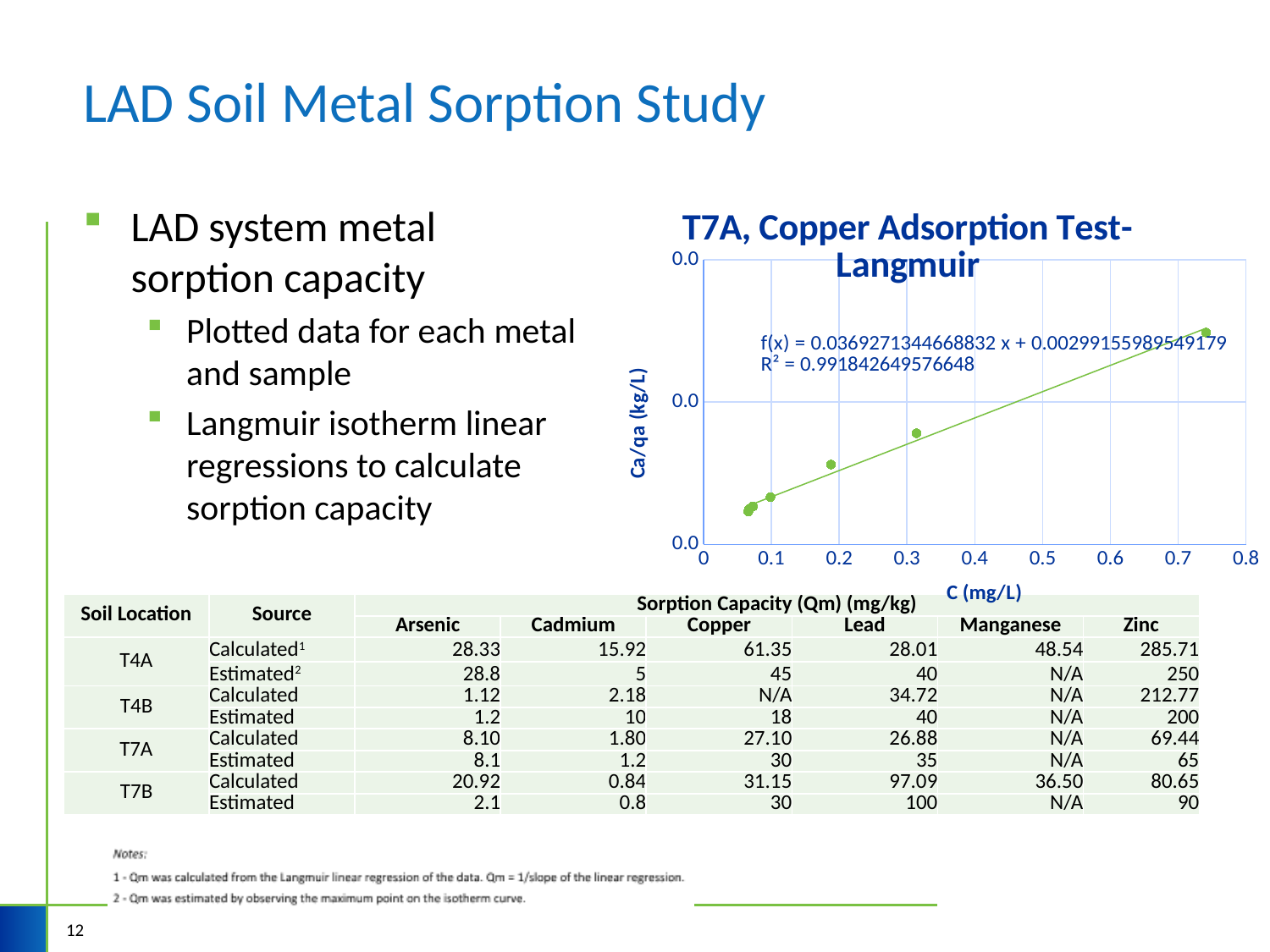
What kind of chart is shown on the slide? Scatter chart with a linear trendline Is the C (mg/L) value of the rightmost plotted point greater or less than 0.7? greater What is the slope of the fitted line f(x) printed on the chart? 0.0369271344668832 What is the title of the chart on the slide? T7A, Copper Adsorption Test- Langmuir Is the C (mg/L) value of the leftmost plotted point greater or less than 0.1? less What is the maximum value shown on the x axis of the chart? 0.8 What is the R² value printed on the chart? 0.991842649576648 What is the label of the x axis of the chart? C (mg/L) What is the intercept of the fitted line f(x) printed on the chart? 0.00299155989549179 Do the plotted Ca/qa values rise or fall as C (mg/L) increases along the x axis? Rise